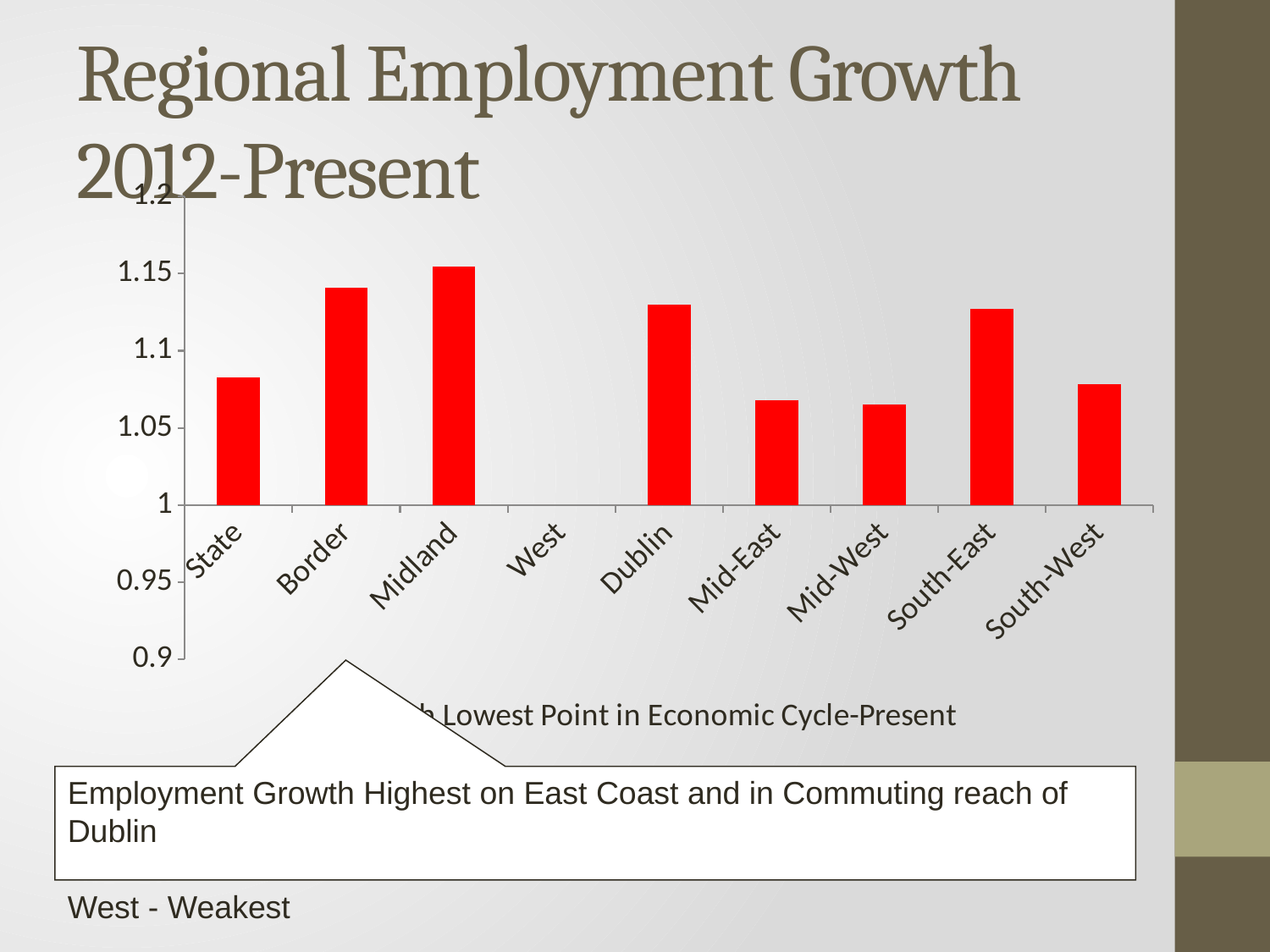
Which is larger, the value for Dublin or the value for Mid-West? Dublin Is the value for South-West greater or less than 1.1? less Is the value for Dublin greater or less than 1.1? greater Is the value for Mid-West greater or less than 1.05? greater Which category has the highest value in the chart? Midland What colour are the bars in the chart? red Which region has the lowest employment growth in the chart? West How many categories are shown on the x axis of the chart? 9 What kind of chart is shown on the slide? bar chart Which is larger, the value for Midland or the value for Dublin? Midland